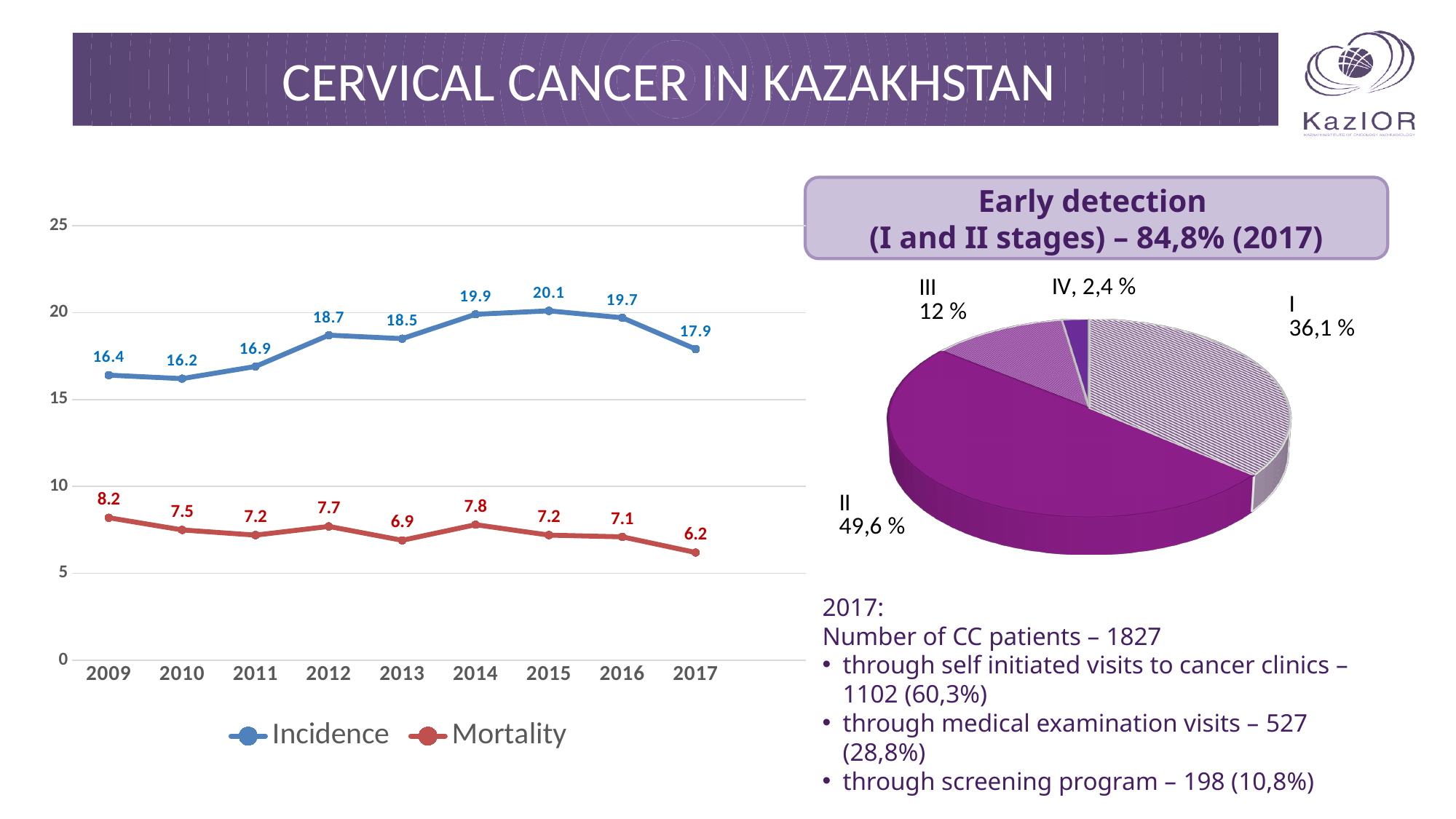
In the line chart on the left, which year has the lowest Mortality value? 2017 In the line chart on the left, what is the Mortality value for 2009? 8.2 In the pie chart on the right, what share does stage II have? 49,6 % In the line chart on the left, what is the difference between the Incidence and Mortality values in 2017? 11.7 In the pie chart on the right, which stage has the smallest slice? IV In the line chart on the left, how many years are shown on the x axis? 9 In the line chart on the left, which year has the highest Incidence value? 2015 In the line chart on the left, does the Incidence series rise or fall from 2009 to 2012? rise In the line chart on the left, is the Mortality value for 2014 larger or smaller than the Mortality value for 2013? larger In the line chart on the left, how many series does the legend list? 2 What kind of chart is shown on the left of the slide? line chart In the line chart on the left, what is the Incidence value for 2015? 20.1